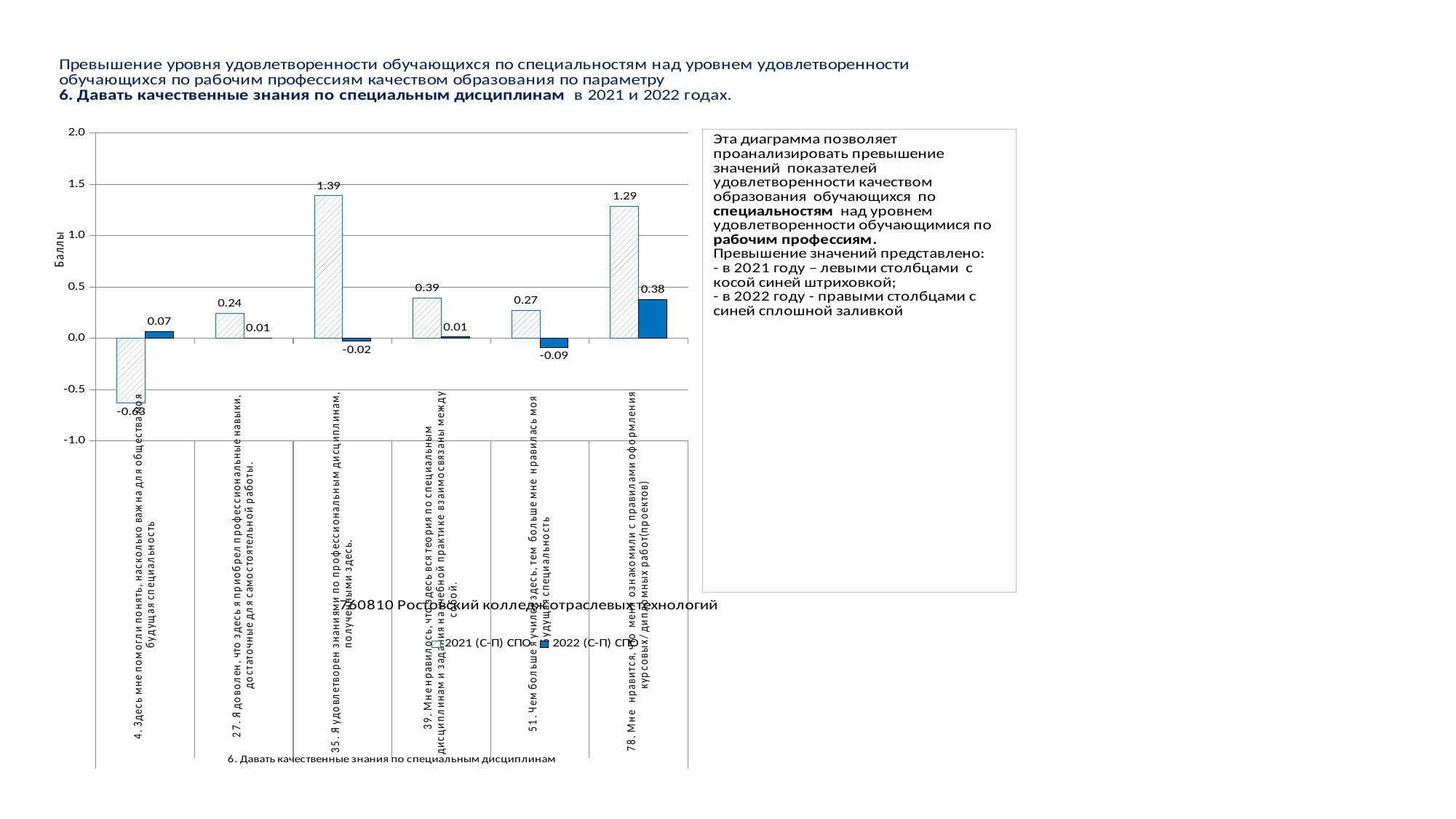
For category 39, which series has the larger value, 2021 (С-П) СПО or 2022 (С-П) СПО? 2021 (С-П) СПО What is the 2022 (С-П) СПО value for category 78 (Мне нравится, что меня ознакомили с правилами оформления курсовых/дипломных работ)? 0.38 What is the 2021 (С-П) СПО value for category 35 (Я удовлетворен знаниями по профессиональным дисциплинам)? 1.39 Which category has the highest 2021 (С-П) СПО value? 35. Я удовлетворен знаниями по профессиональным дисциплинам, полученными здесь. What type of chart is shown on the slide? bar chart What is the 2022 (С-П) СПО value for category 51 (Чем больше я учился здесь, тем больше мне нравилась моя будущая специальность)? -0.09 What is the difference between the 2021 and 2022 values for category 78? 0.91 How many categories are shown on the x axis? 6 How many series does the legend list? 2 What is the 2021 (С-П) СПО value for category 27 (Я доволен, что здесь я приобрел профессиональные навыки)? 0.24 Which category has the lowest 2022 (С-П) СПО value? 51. Чем больше я учился здесь, тем больше мне нравилась моя будущая специальность Is the 2021 (С-П) СПО value for category 4 greater or less than -0.5? less